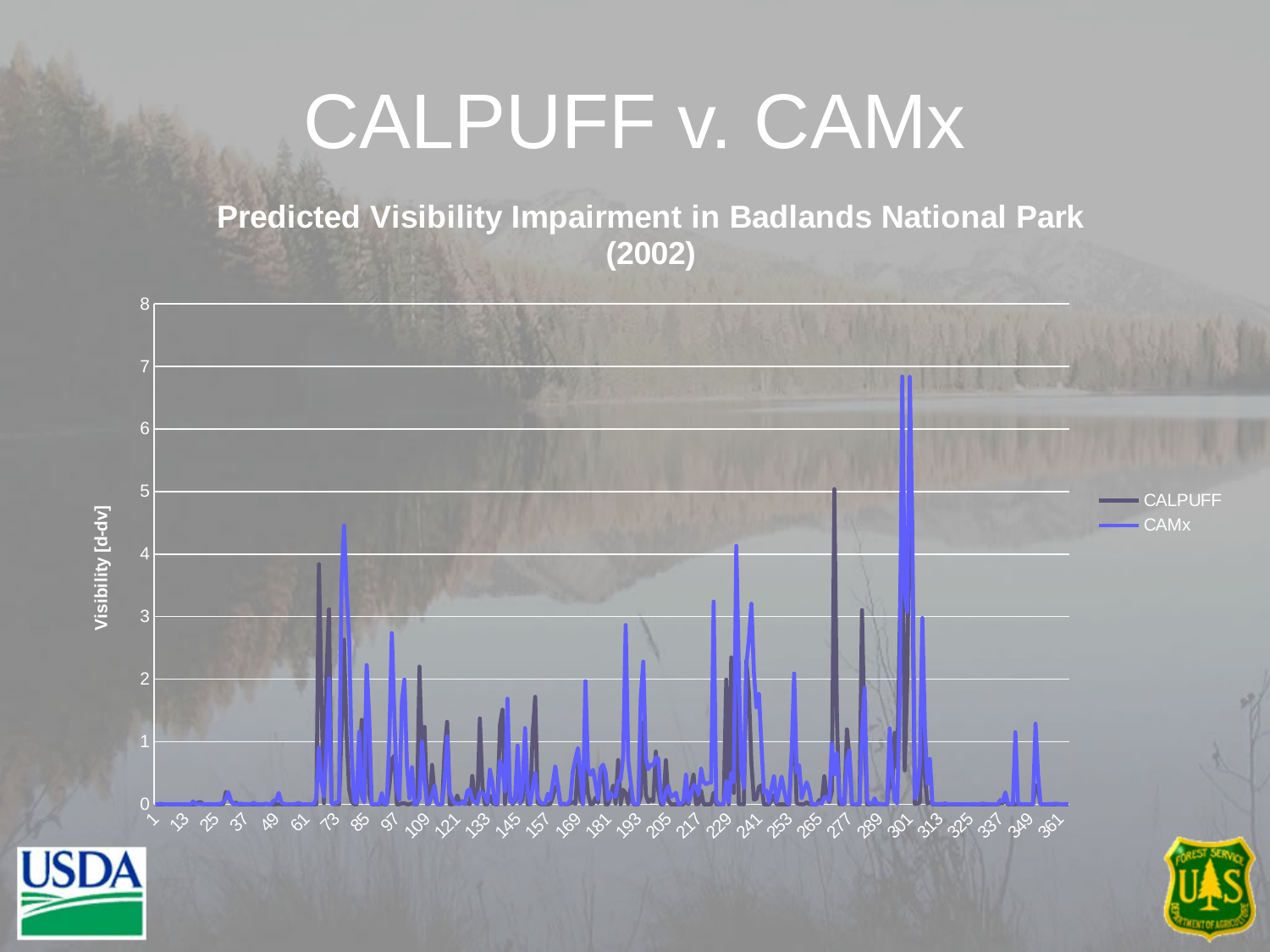
What is the maximum value shown on the vertical axis? 8 How many series does the legend list? 2 Is the CALPUFF peak near day 67 greater or less than 3? greater Does either series ever exceed 7 on the vertical axis? no What kind of chart is shown on the slide? line chart Is the CAMx peak near day 73 greater or less than 4? greater Which series reaches the highest value anywhere on the chart, CALPUFF or CAMx? CAMx What is the title of the chart? Predicted Visibility Impairment in Badlands National Park (2002) What is the label on the vertical axis of the chart? Visibility [d-dv] Which series has the higher peak around day 301, CALPUFF or CAMx? CAMx